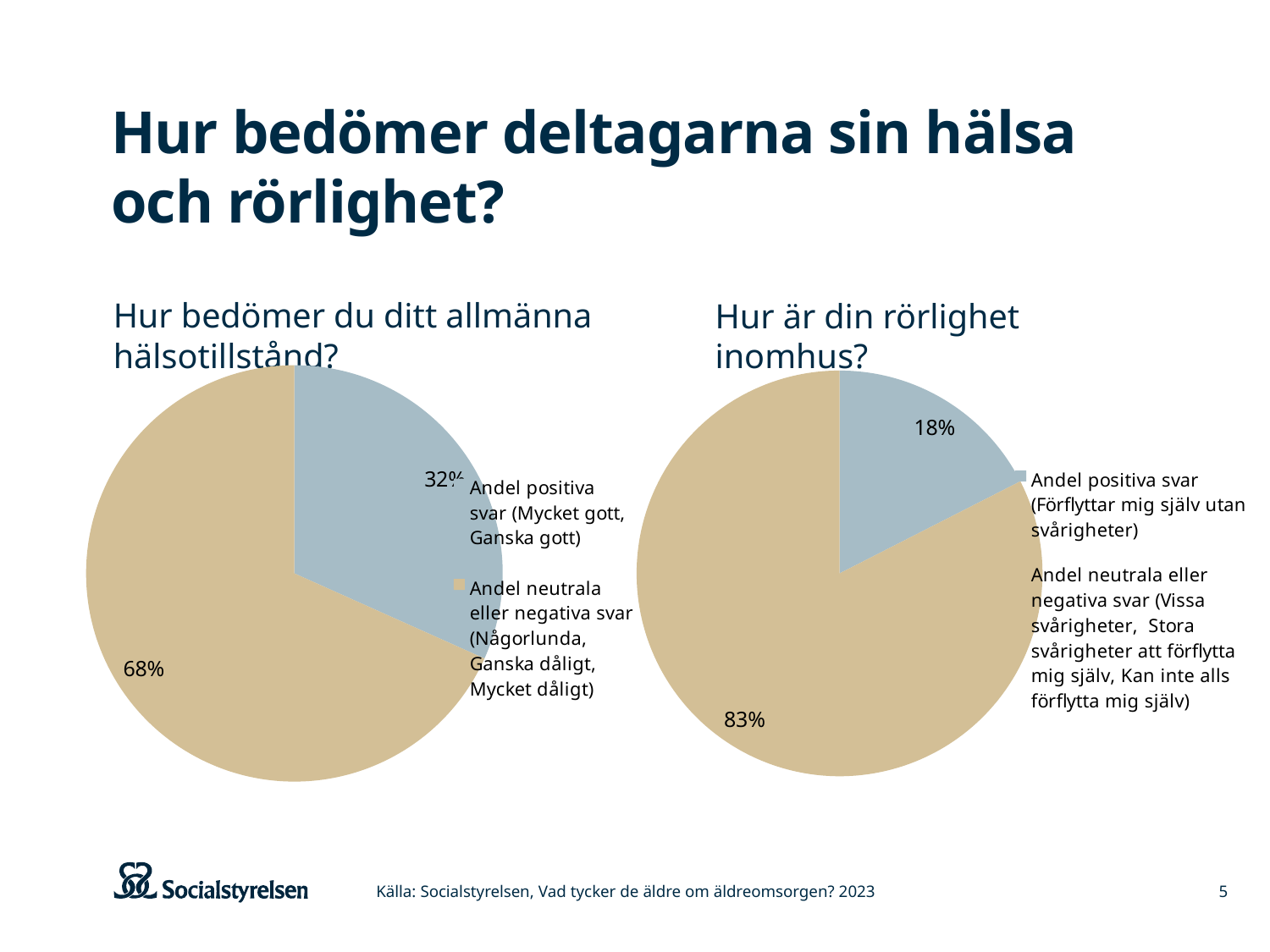
In the chart "Hur är din rörlighet inomhus?", which slice is the largest? Andel neutrala eller negativa svar In the chart "Hur är din rörlighet inomhus?", what share is labelled for "Andel neutrala eller negativa svar"? 83% In the chart "Hur bedömer du ditt allmänna hälsotillstånd?", what is the difference in percentage points between the neutral/negative slice and the positive slice? 36 percentage points In the chart "Hur är din rörlighet inomhus?", what share is labelled for "Andel positiva svar"? 18% In the chart "Hur bedömer du ditt allmänna hälsotillstånd?", what share is labelled for "Andel positiva svar"? 32% What kind of chart is used on the slide for "Hur bedömer du ditt allmänna hälsotillstånd?"? Pie chart Which chart shows a larger share of positive answers, "Hur bedömer du ditt allmänna hälsotillstånd?" or "Hur är din rörlighet inomhus?"? Hur bedömer du ditt allmänna hälsotillstånd? In the chart "Hur bedömer du ditt allmänna hälsotillstånd?", what colour is the slice for "Andel positiva svar"? Blue-grey In the chart "Hur är din rörlighet inomhus?", what is the difference in percentage points between the neutral/negative slice and the positive slice? 65 percentage points In the chart "Hur bedömer du ditt allmänna hälsotillstånd?", which slice is the smallest? Andel positiva svar How many slices does the chart "Hur är din rörlighet inomhus?" have? 2 In the chart "Hur bedömer du ditt allmänna hälsotillstånd?", what share is labelled for "Andel neutrala eller negativa svar"? 68%